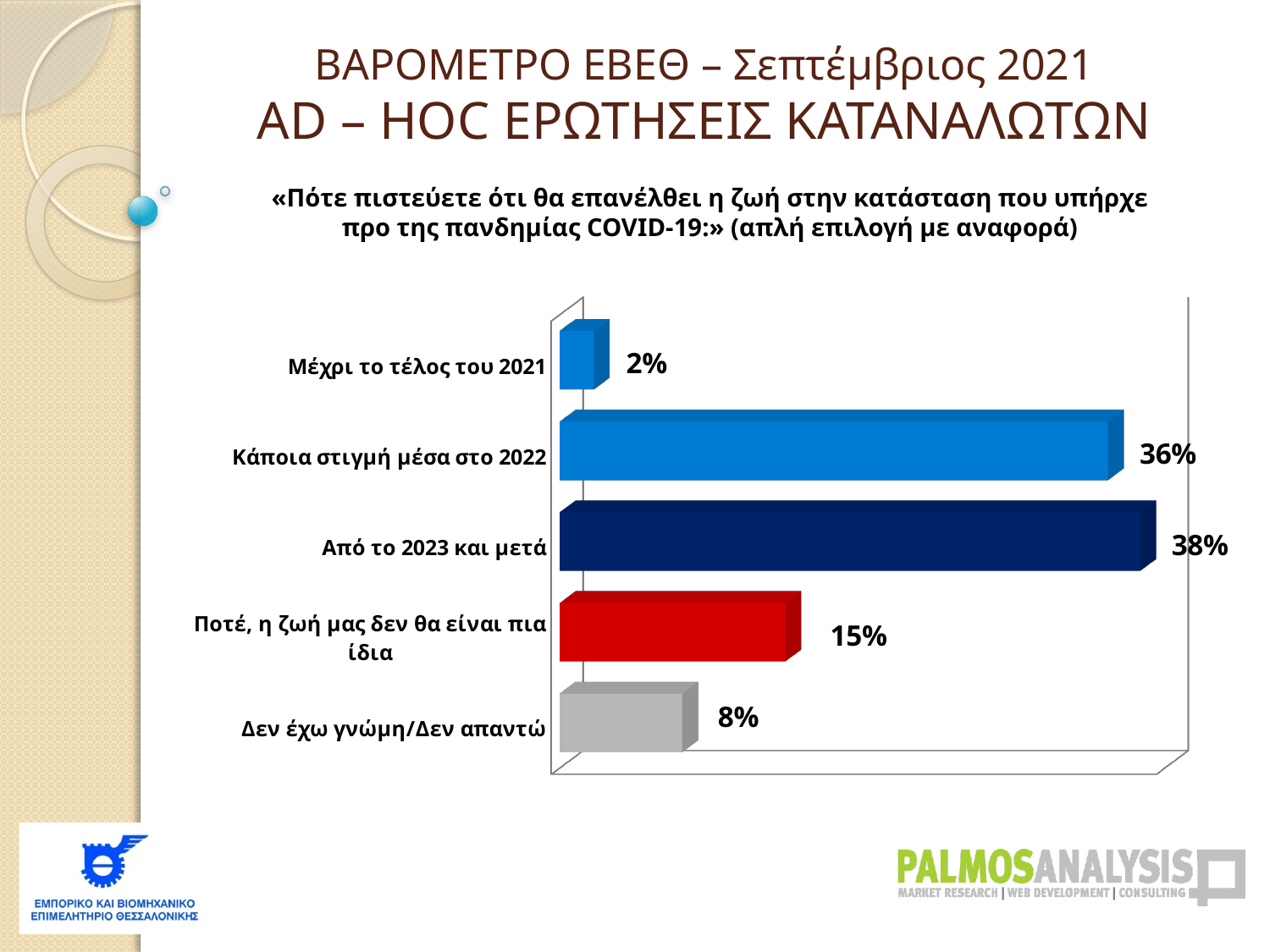
What percentage of respondents answered "Μέχρι το τέλος του 2021"? 2% What colour is the bar for "Ποτέ, η ζωή μας δεν θα είναι πια ίδια"? Red What is the value for "Δεν έχω γνώμη/Δεν απαντώ"? 8% What type of chart is shown on the slide? Bar chart How many categories are shown in the chart? 5 What is the difference between the values for "Από το 2023 και μετά" and "Κάποια στιγμή μέσα στο 2022"? 2% Which category has the highest value? Από το 2023 και μετά What is the value for "Από το 2023 και μετά"? 38% What is the value for "Κάποια στιγμή μέσα στο 2022"? 36% Which is larger: the value for "Ποτέ, η ζωή μας δεν θα είναι πια ίδια" or for "Δεν έχω γνώμη/Δεν απαντώ"? Ποτέ, η ζωή μας δεν θα είναι πια ίδια Which category has the lowest value? Μέχρι το τέλος του 2021 What percentage chose "Ποτέ, η ζωή μας δεν θα είναι πια ίδια"? 15%